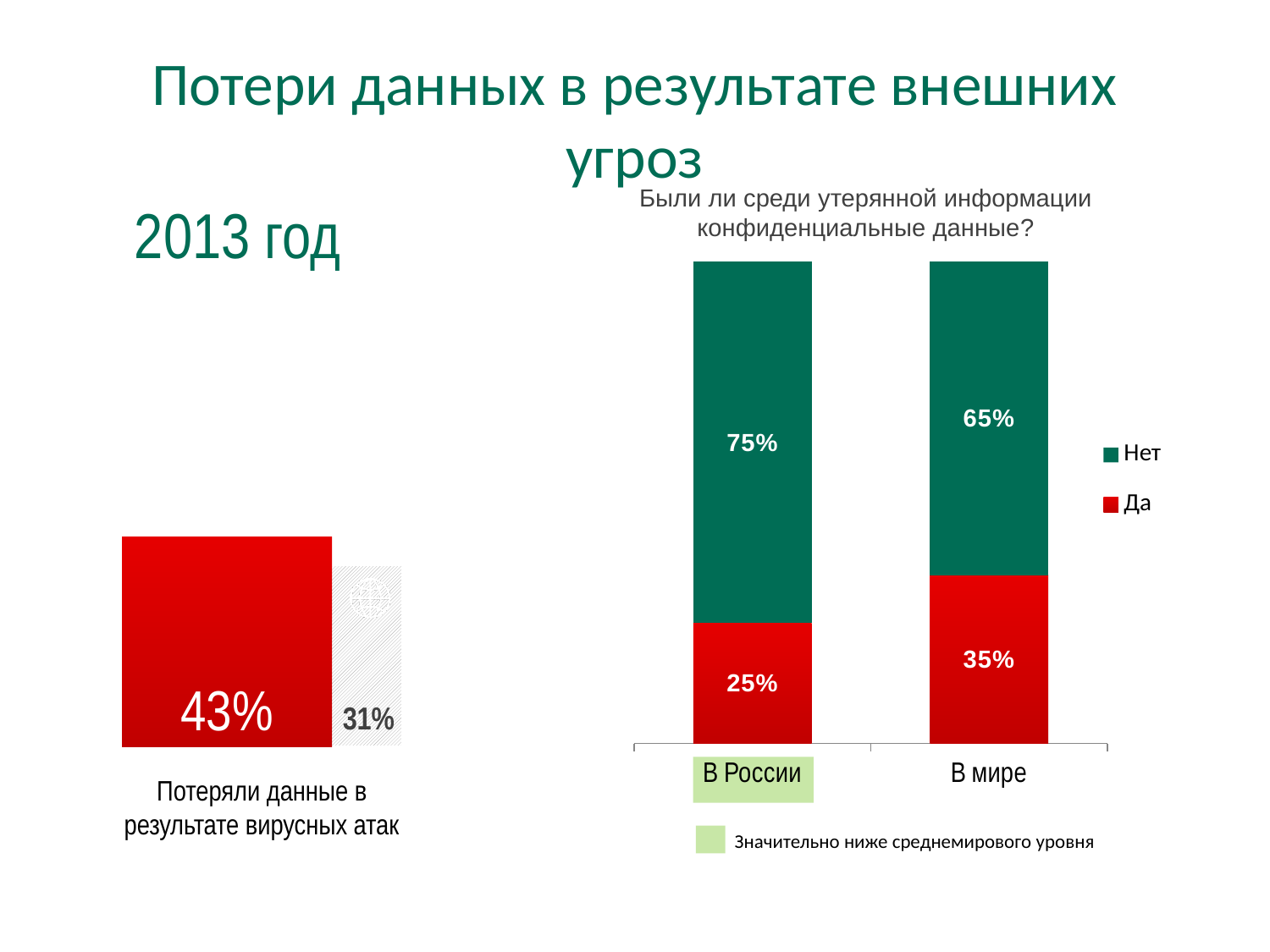
What kind of chart is the chart titled "Были ли среди утерянной информации конфиденциальные данные?"? Stacked bar chart In the stacked bar chart titled "Были ли среди утерянной информации конфиденциальные данные?", what is the value of the "Нет" segment for "В России"? 75% In the chart on the left labelled "Потеряли данные в результате вирусных атак", what is the difference between the red bar value and the grey hatched bar value? 12% How many categories are shown on the x axis of the stacked bar chart titled "Были ли среди утерянной информации конфиденциальные данные?"? 2 In the stacked bar chart titled "Были ли среди утерянной информации конфиденциальные данные?", what is the value of the "Нет" segment for "В мире"? 65% In the stacked bar chart titled "Были ли среди утерянной информации конфиденциальные данные?", what is the difference between the "Да" values for "В мире" and "В России"? 10% In the stacked bar chart titled "Были ли среди утерянной информации конфиденциальные данные?", what is the total of the stacked bar for "В России"? 100% In the stacked bar chart titled "Были ли среди утерянной информации конфиденциальные данные?", what is the value of the "Да" segment for "В мире"? 35% In the stacked bar chart titled "Были ли среди утерянной информации конфиденциальные данные?", what is the value of the "Да" segment for "В России"? 25% In the stacked bar chart titled "Были ли среди утерянной информации конфиденциальные данные?", which category has the larger "Да" segment, "В России" or "В мире"? В мире How many series does the legend of the stacked bar chart titled "Были ли среди утерянной информации конфиденциальные данные?" list? 2 In the chart on the left labelled "Потеряли данные в результате вирусных атак", what value is shown on the red bar? 43%